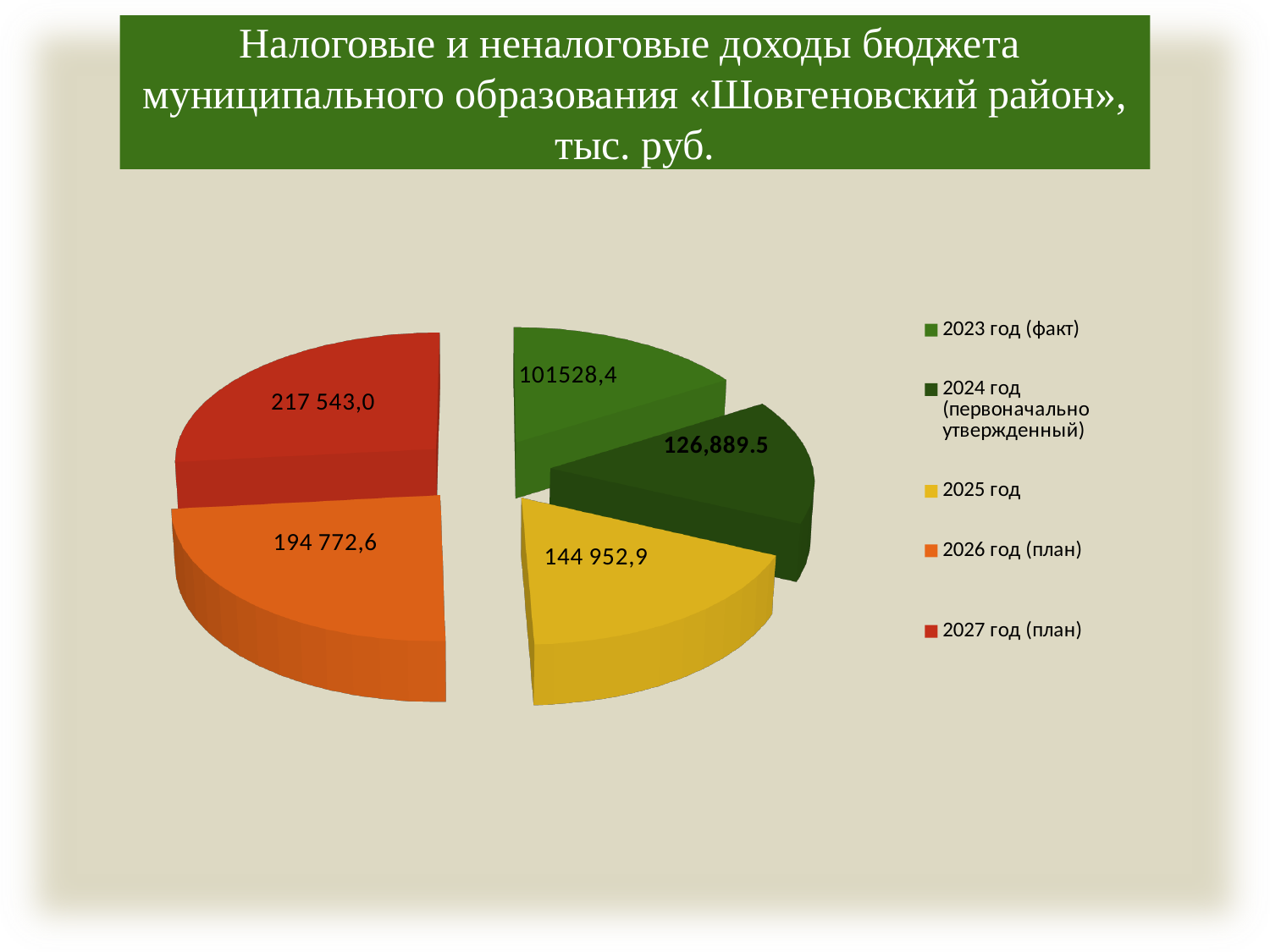
What is the difference between the values for 2025 год and 2023 год (факт)? 43 424,5 How many slices does the pie chart have? 5 Which is larger, the value for 2026 год (план) or the value for 2025 год? 2026 год (план) What is the difference between the values for 2027 год (план) and 2026 год (план)? 22 770,4 Which category has the largest slice of the pie? 2027 год (план) What is the value for 2027 год (план)? 217 543,0 What colour is the slice for 2026 год (план)? Orange What kind of chart is shown on the slide? Pie chart What is the value for 2024 год (первоначально утвержденный)? 126,889.5 What is the value for 2025 год? 144 952,9 What is the value for 2023 год (факт)? 101528,4